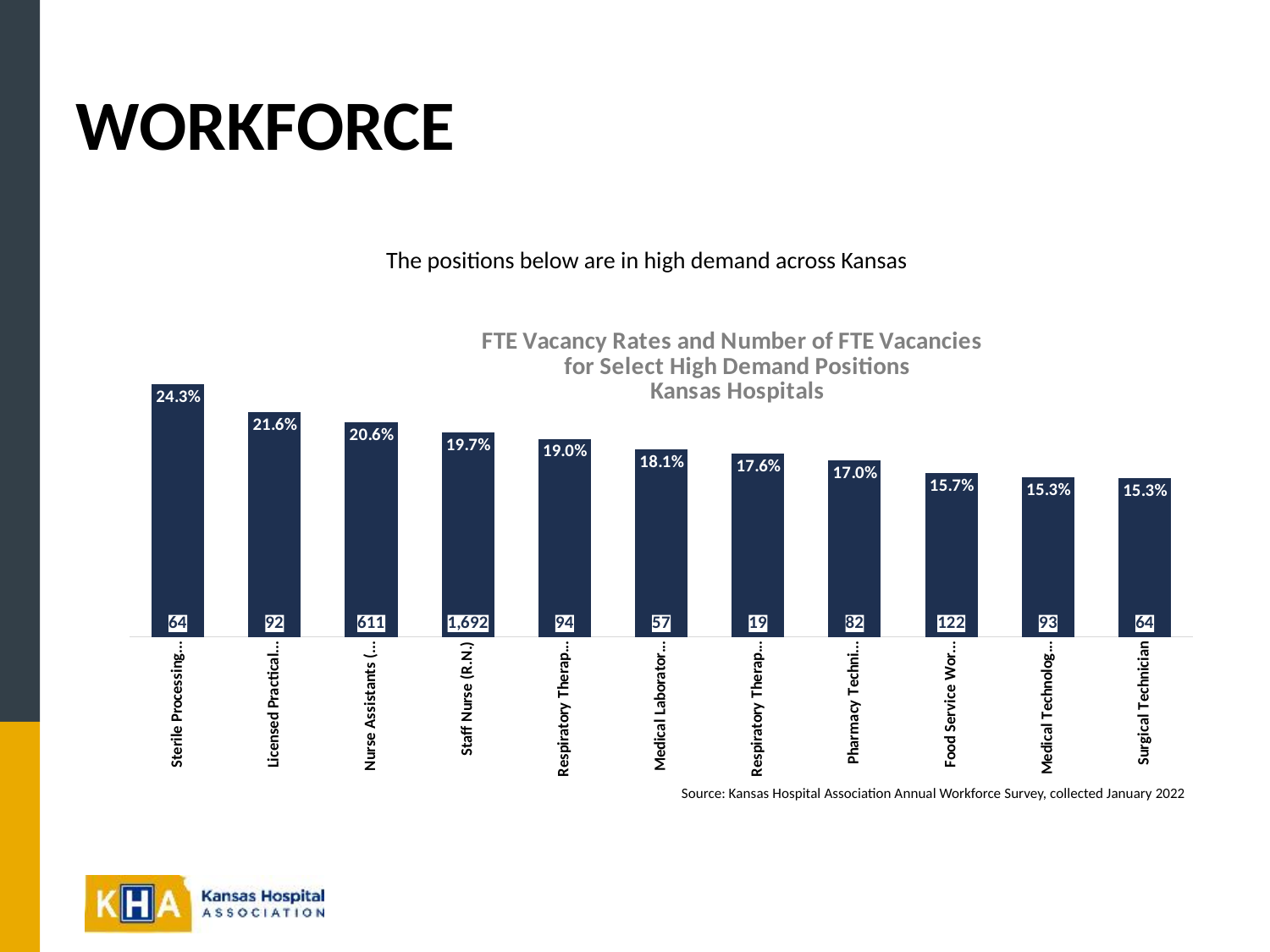
What is the difference in FTE vacancy rate between Staff Nurse (R.N.) and Surgical Technician? 4.4 percentage points Which position has the largest number of FTE vacancies? Staff Nurse (R.N.) Do the FTE vacancy rates rise or fall from left to right across the chart? Fall What kind of chart is shown on the slide? Bar chart How many positions are shown on the chart? 11 What is the highest FTE vacancy rate shown on the chart? 24.3% What is the FTE vacancy rate for Staff Nurse (R.N.)? 19.7% What is the FTE vacancy rate for Surgical Technician? 15.3% What is the lowest FTE vacancy rate shown on the chart? 15.3% How many FTE vacancies are shown for Surgical Technician? 64 Which has a higher FTE vacancy rate, Staff Nurse (R.N.) or Surgical Technician? Staff Nurse (R.N.) How many FTE vacancies are shown for Staff Nurse (R.N.)? 1,692